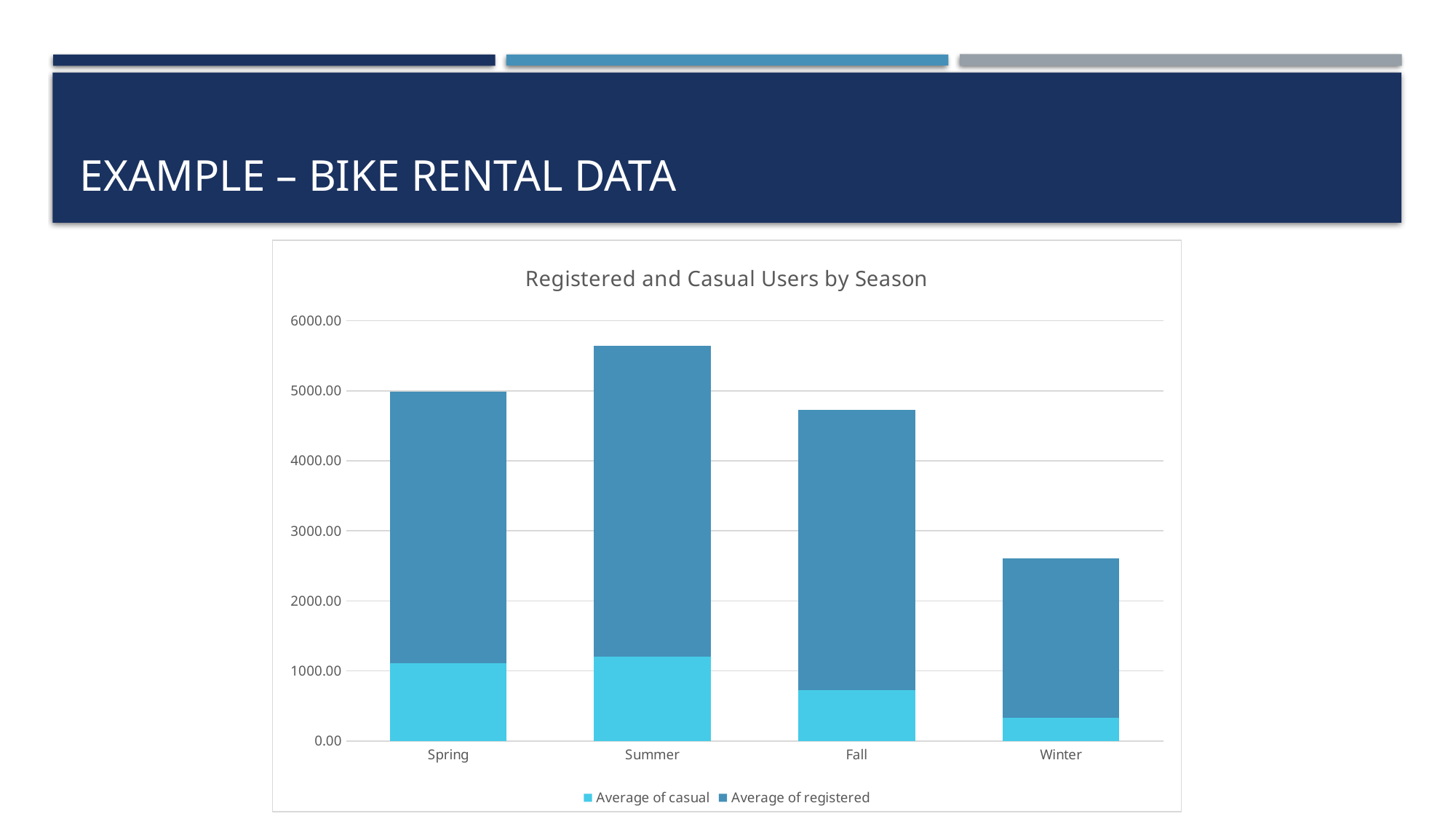
Which series does the lighter blue colour represent in the chart? Average of casual Which season has the lowest Average of casual value? Winter Is the total stacked bar for Winter greater or less than 3000.00? less Which season has the lowest total stacked bar? Winter How many series does the chart's legend list? 2 What kind of chart is shown on the slide? Stacked bar chart Which has the larger total stacked bar, Spring or Fall? Spring What is the title of the chart? Registered and Casual Users by Season How many seasons are shown on the x axis of the chart? 4 Is the total stacked bar for Summer greater or less than 5000.00? greater Which season has the highest total stacked bar? Summer Is the Average of casual value for Fall greater or less than 1000.00? less